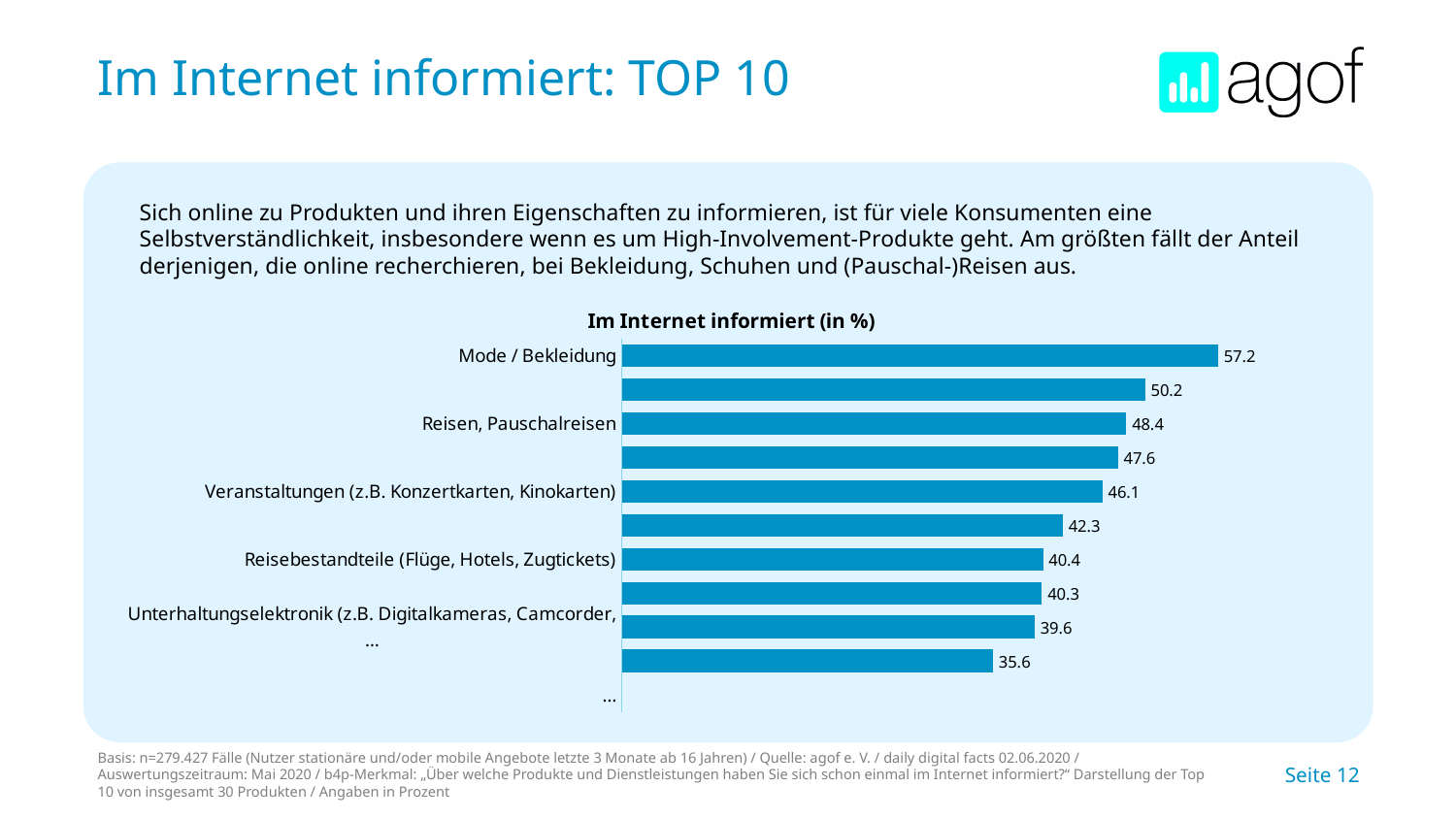
How many bars are plotted in the chart? 10 Which category has the highest value in the chart? Mode / Bekleidung What value is shown for Unterhaltungselektronik (z.B. Digitalkameras, Camcorder, ...)? 39.6 What is the smallest value shown in the chart? 35.6 Which is larger: the value for Reisen, Pauschalreisen or the value for Veranstaltungen (z.B. Konzertkarten, Kinokarten)? Reisen, Pauschalreisen What kind of chart is shown on the slide? Bar chart What is the difference between the values for Mode / Bekleidung and Reisen, Pauschalreisen? 8.8 What value is shown for Veranstaltungen (z.B. Konzertkarten, Kinokarten)? 46.1 What value is shown for Mode / Bekleidung? 57.2 What value is shown for Reisen, Pauschalreisen? 48.4 What value is shown for Reisebestandteile (Flüge, Hotels, Zugtickets)? 40.4 What is the title of the chart? Im Internet informiert (in %)